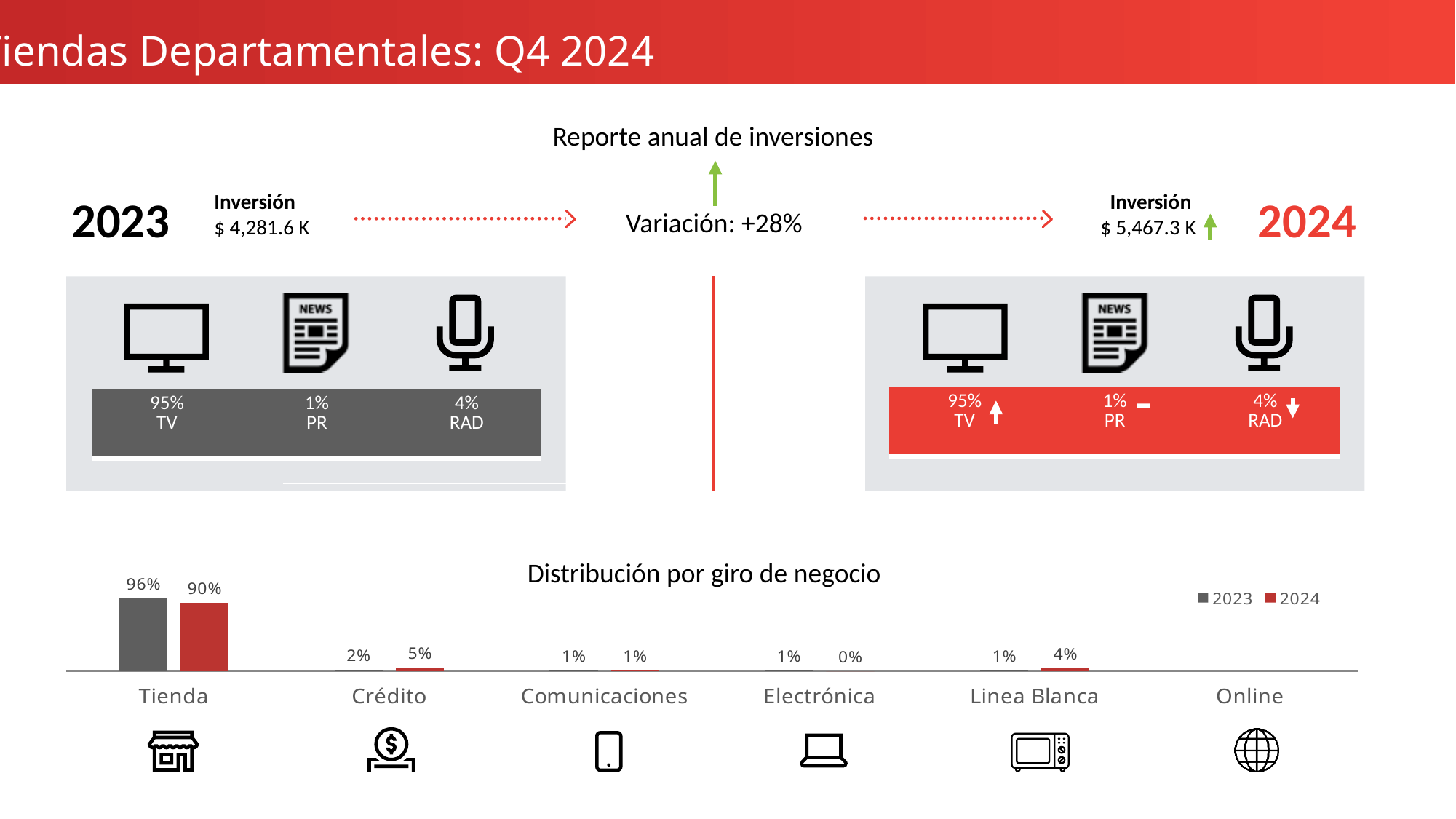
In the 'Distribución por giro de negocio' chart, what is the difference between the 2024 and 2023 values for Crédito? 3% What kind of chart is 'Distribución por giro de negocio'? Bar chart How many categories are shown on the x axis of the 'Distribución por giro de negocio' chart? 6 How many series does the legend of the 'Distribución por giro de negocio' chart list? 2 In the 'Distribución por giro de negocio' chart, what is the 2024 value for Tienda? 90% In the 'Distribución por giro de negocio' chart, what is the 2023 value for Tienda? 96% In the 'Distribución por giro de negocio' chart, what is the 2024 value for Electrónica? 0% In the 'Distribución por giro de negocio' chart, which category has the highest 2023 value? Tienda In the 'Distribución por giro de negocio' chart, what is the 2024 value for Crédito? 5% In the 'Distribución por giro de negocio' chart, what is the 2024 value for Linea Blanca? 4% In the 'Distribución por giro de negocio' chart, which is larger for Linea Blanca: the 2023 value or the 2024 value? 2024 In the 'Distribución por giro de negocio' chart, what is the difference between the 2023 and 2024 values for Tienda? 6%